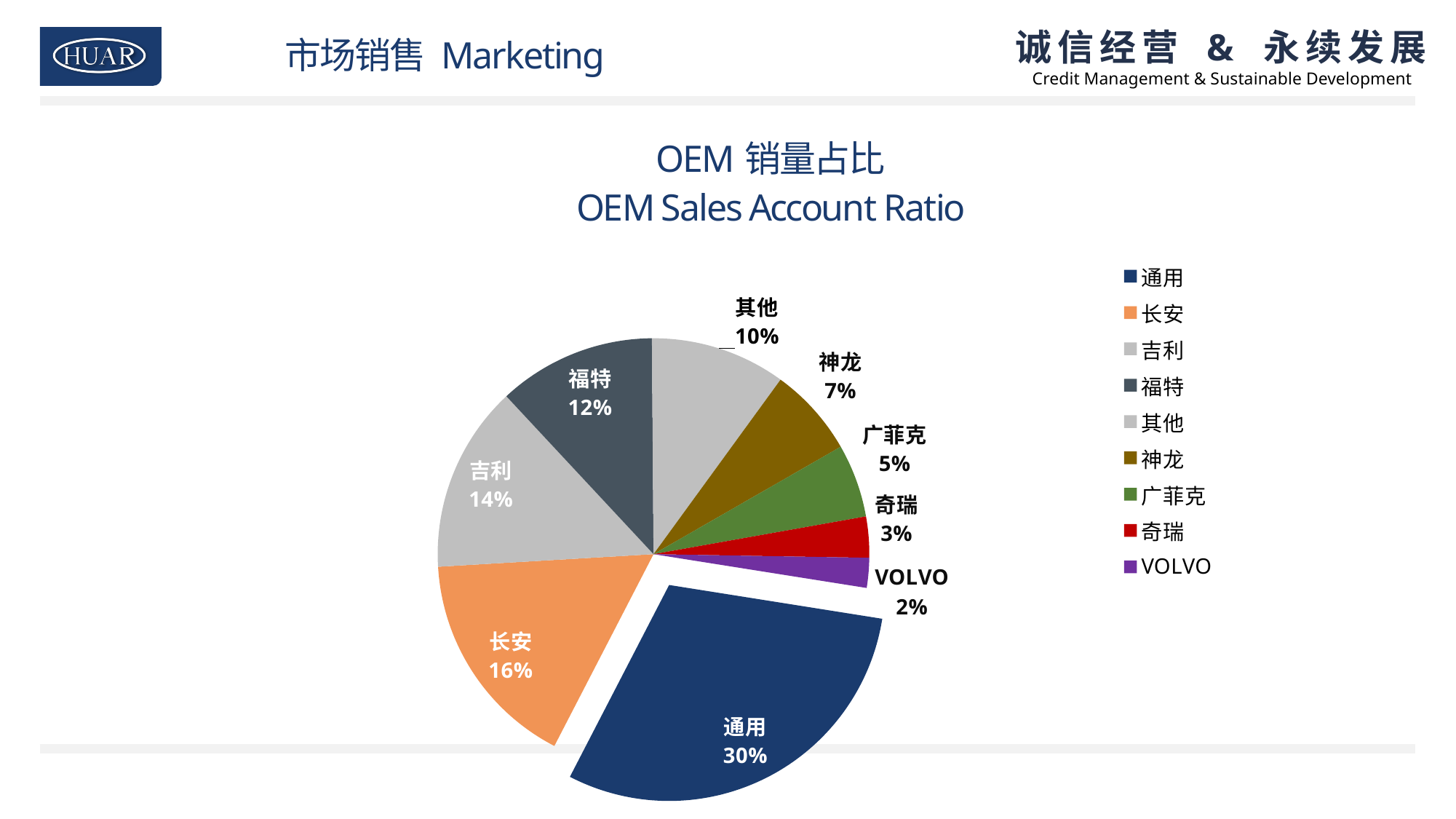
How many categories are shown in the pie chart? 9 What is the difference between the shares of 吉利 and 福特? 2% Which OEM has the smallest share of sales? VOLVO Which OEM has the largest share of sales? 通用 What percentage is shown for 神龙? 7% What is the English title of the chart? OEM Sales Account Ratio What kind of chart is shown on the slide? Pie chart Which has a larger share, 其他 or 广菲克? 其他 What is the value for VOLVO? 2% What share of OEM sales does 通用 account for? 30% What is the value shown for 长安? 16% What is the combined share of 通用 and 长安? 46%